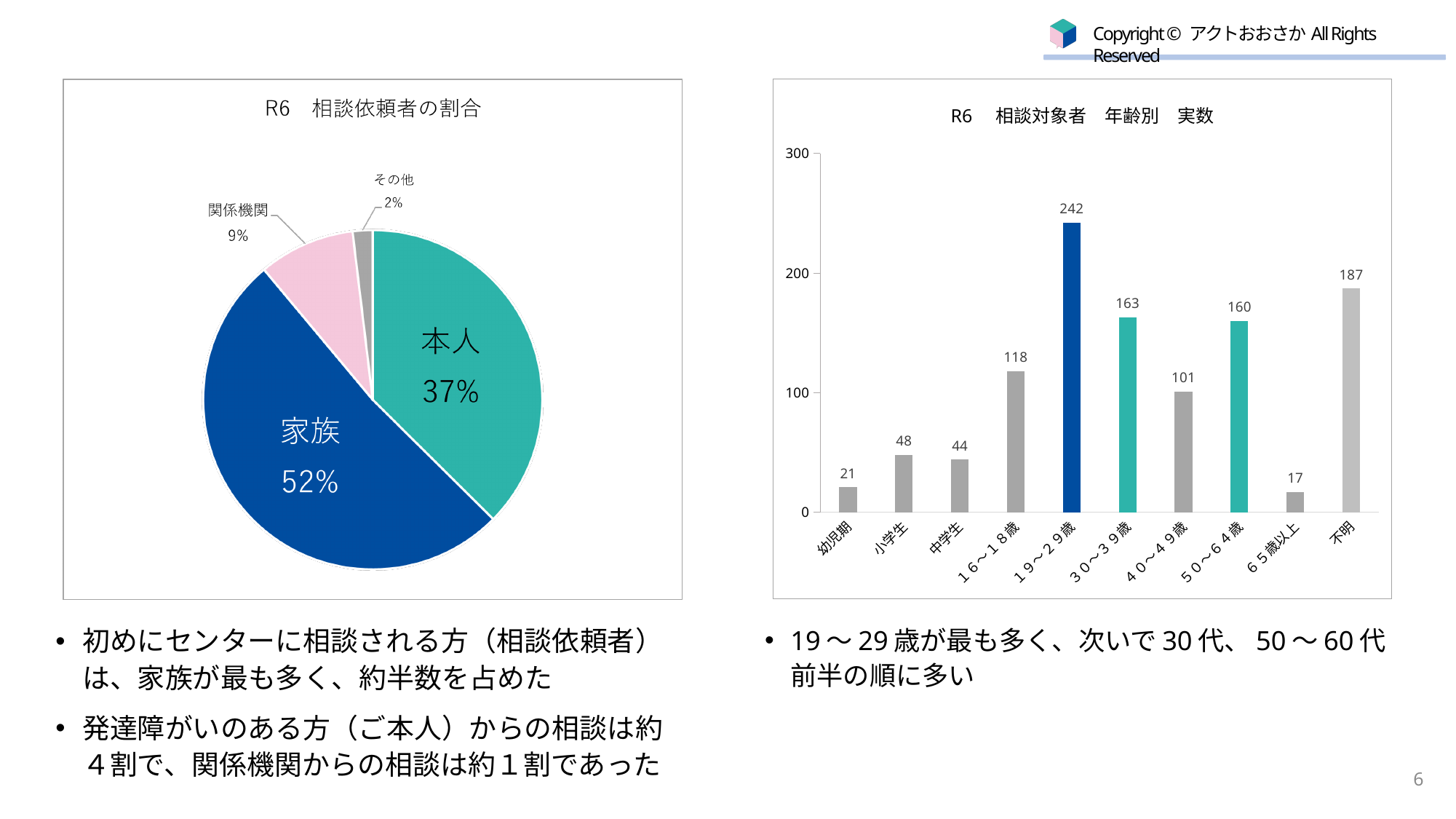
In the pie chart titled 'R6 相談依頼者の割合', how many slices are there? 4 In the bar chart titled 'R6 相談対象者 年齢別 実数', which category has the lowest value? 65歳以上 In the bar chart titled 'R6 相談対象者 年齢別 実数', what is the difference between the values for 30～39歳 and 50～64歳? 3 What kind of chart is the chart on the right titled 'R6 相談対象者 年齢別 実数'? bar chart In the bar chart titled 'R6 相談対象者 年齢別 実数', which is larger, the value for 小学生 or the value for 中学生? 小学生 In the bar chart titled 'R6 相談対象者 年齢別 実数', what is the value for 19～29歳? 242 In the pie chart titled 'R6 相談依頼者の割合', what is the difference in percentage points between 家族 and 本人? 15 In the pie chart titled 'R6 相談依頼者の割合', what share does 関係機関 have? 9% In the pie chart titled 'R6 相談依頼者の割合', which category has the smallest share? その他 In the bar chart titled 'R6 相談対象者 年齢別 実数', what is the value for 不明? 187 In the pie chart titled 'R6 相談依頼者の割合', what share does 家族 have? 52% In the bar chart titled 'R6 相談対象者 年齢別 実数', how many categories are shown on the x axis? 10